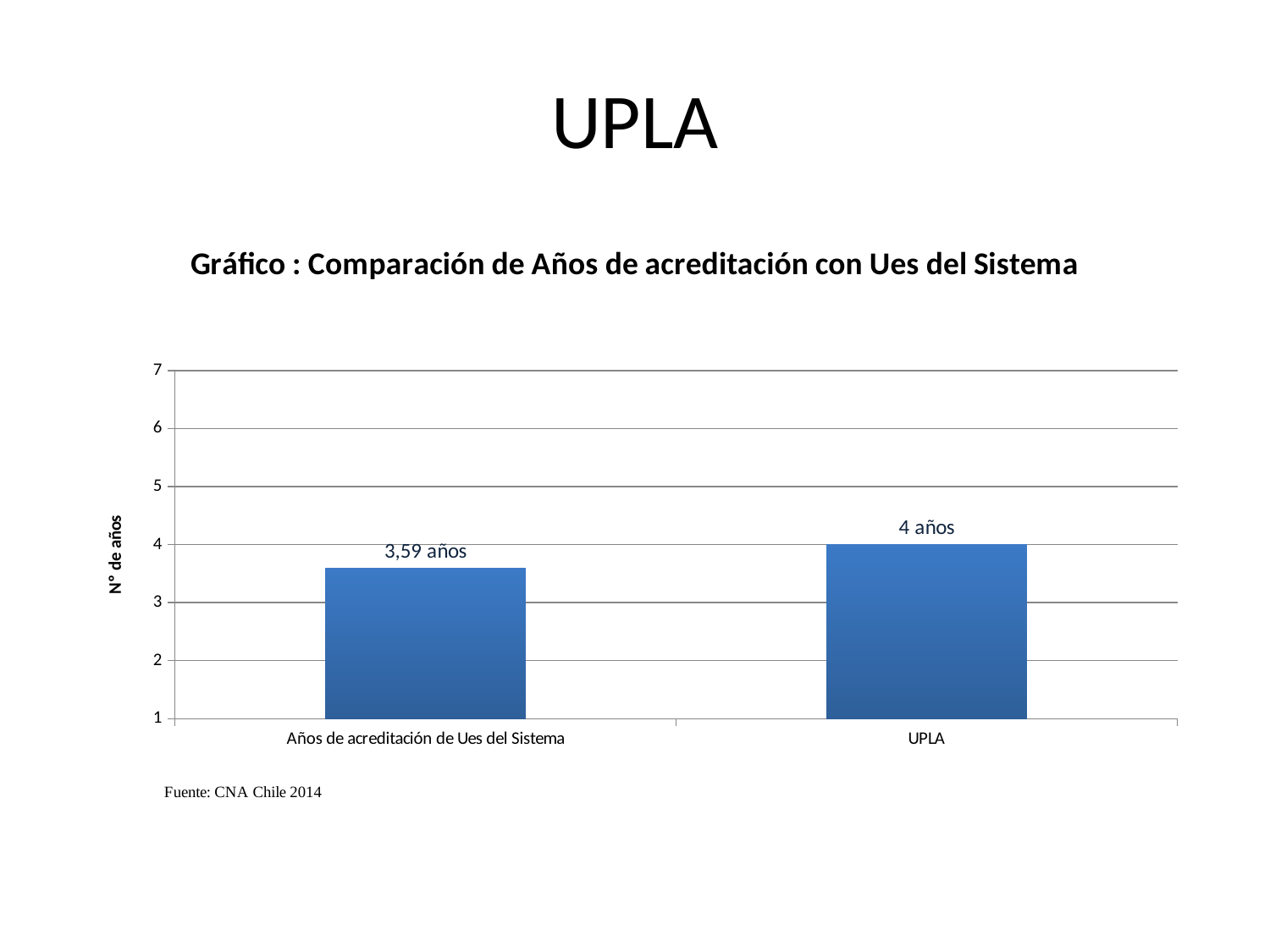
Is the value for Años de acreditación de Ues del Sistema greater or less than 4? less What is the title of the chart? Gráfico : Comparación de Años de acreditación con Ues del Sistema What is the label of the y axis? N° de años What is the highest value shown on the y axis? 7 Which category has the highest value? UPLA How many categories are shown on the x axis? 2 What is the value for UPLA? 4 años What is the value for Años de acreditación de Ues del Sistema? 3,59 años What is the difference between the value for UPLA and the value for Años de acreditación de Ues del Sistema? 0,41 años Which category has the lowest value? Años de acreditación de Ues del Sistema Which is larger, the value for UPLA or the value for Años de acreditación de Ues del Sistema? UPLA What kind of chart is shown on the slide? bar chart